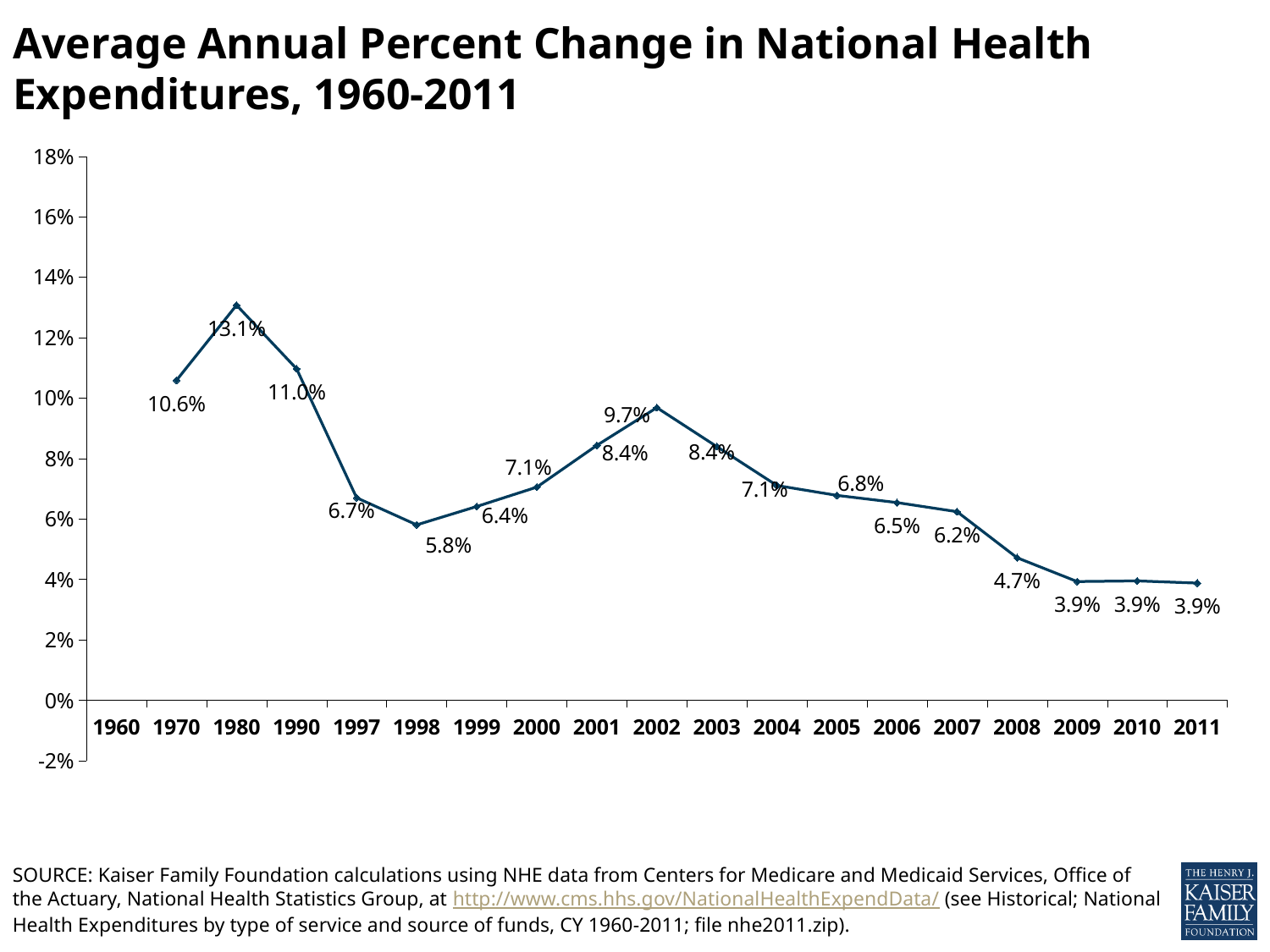
Do the values rise or fall from 2002 to 2011? Fall Which year has the highest average annual percent change? 1980 What type of chart is shown on the slide? Line chart What value is shown for 2011? 3.9% What is the difference between the values for 1980 and 1970? 2.5 percentage points What is the lowest value plotted on the chart? 3.9% What value is shown for 2002? 9.7% Which is larger, the value for 1990 or the value for 2002? 1990 What is the average annual percent change in national health expenditures shown for 1980? 13.1% What is the title of the chart? Average Annual Percent Change in National Health Expenditures, 1960-2011 What is the difference between the values for 2002 and 2011? 5.8 percentage points What value is shown for 1998? 5.8%